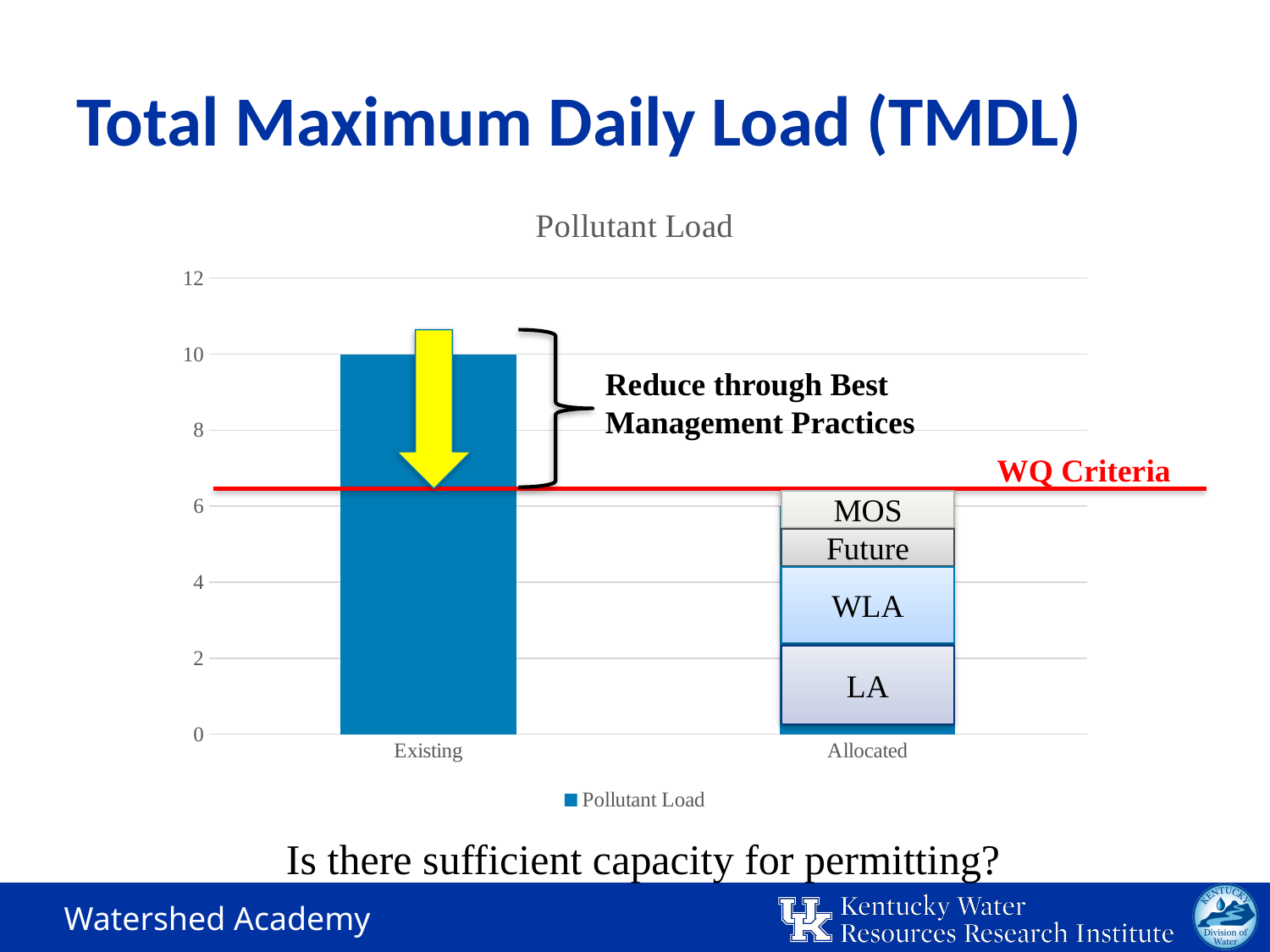
How many categories are shown on the x axis of the chart? 2 Do the values rise or fall from Existing to Allocated along the x axis? fall Is the value for Allocated greater or less than 4? greater Which is larger, the pollutant load for Existing or for Allocated? Existing What is the title of the chart? Pollutant Load What kind of chart is shown on the slide? bar chart What label is given to the red horizontal line on the chart? WQ Criteria Which category has the lowest pollutant load? Allocated Is the value for Allocated greater or less than 8? less Which category has the highest pollutant load? Existing How many series does the chart legend list? 1 What is the pollutant load value for the Existing category? 10